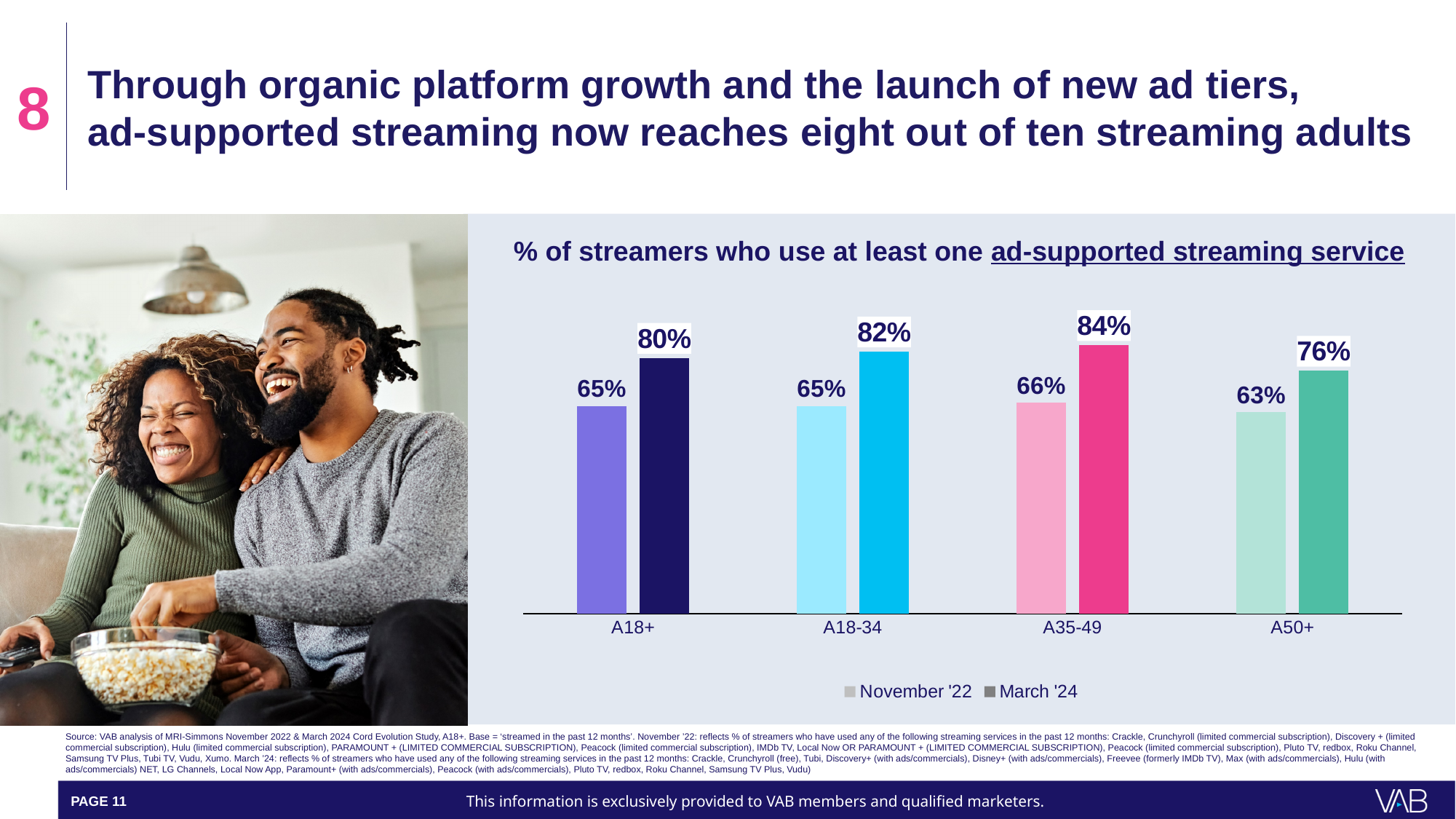
Which age group has the highest March '24 value? A35-49 Which is larger for A18-34: the November '22 value or the March '24 value? March '24 What is the difference between the March '24 and November '22 values for A18+? 15 percentage points What is the March '24 value for A18+? 80% Which age group has the lowest March '24 value? A50+ What is the March '24 value for A35-49? 84% How many age groups are shown on the x axis? 4 What is the November '22 value for A18-34? 65% What is the difference between the March '24 and November '22 values for A50+? 13 percentage points What kind of chart is shown on the slide? Bar chart What is the November '22 value for A50+? 63% How many series does the legend list? 2